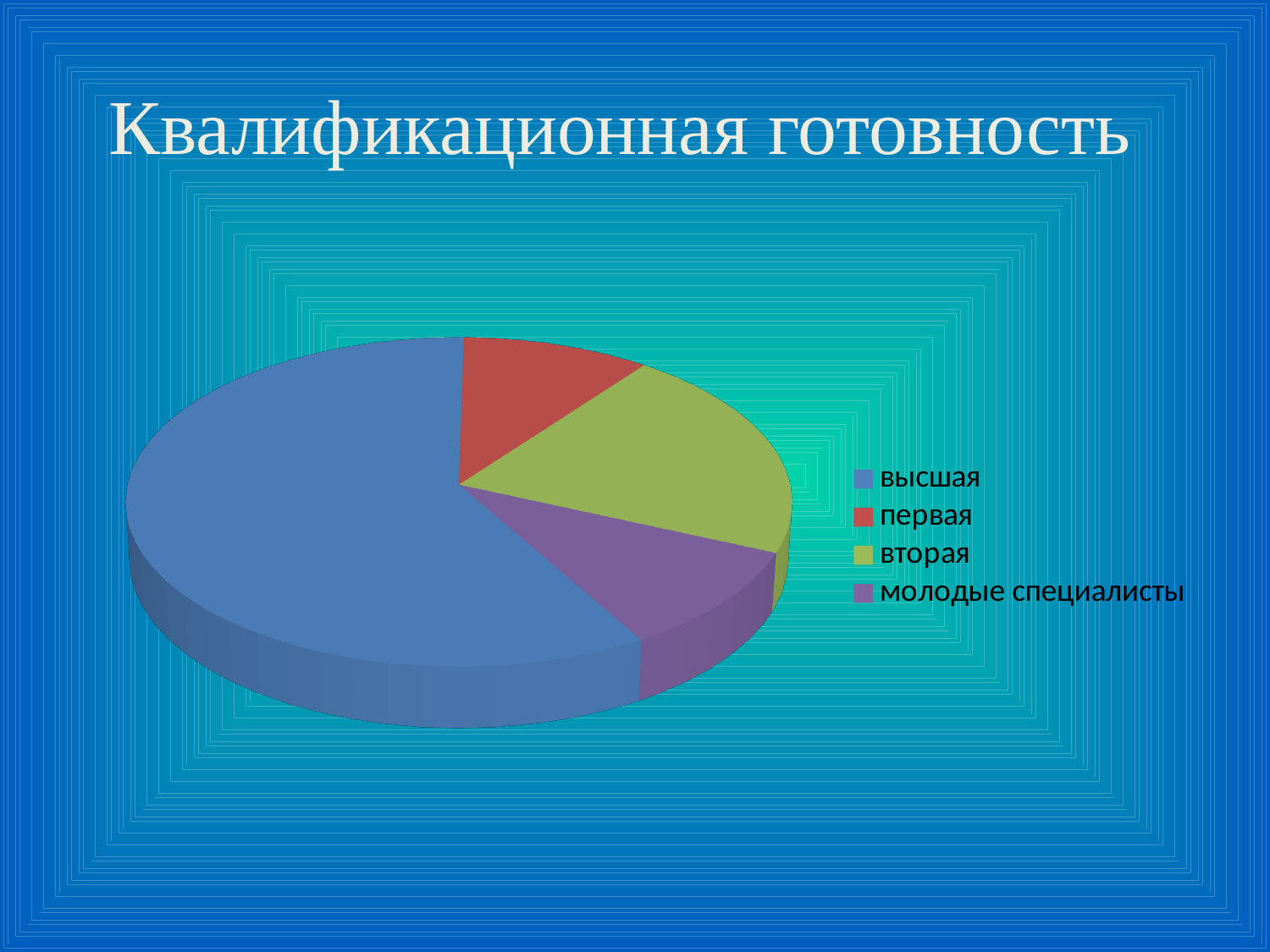
What is the title of the chart on the slide? Квалификационная готовность Which slice is larger, вторая or первая? вторая Which slice is larger, вторая or молодые специалисты? вторая Which slice is larger, высшая or вторая? высшая What colour is the slice for высшая? blue Which category has the largest slice of the pie? высшая How many categories (slices) does the pie chart have? 4 What kind of chart is shown on the slide? pie chart How many entries does the legend list? 4